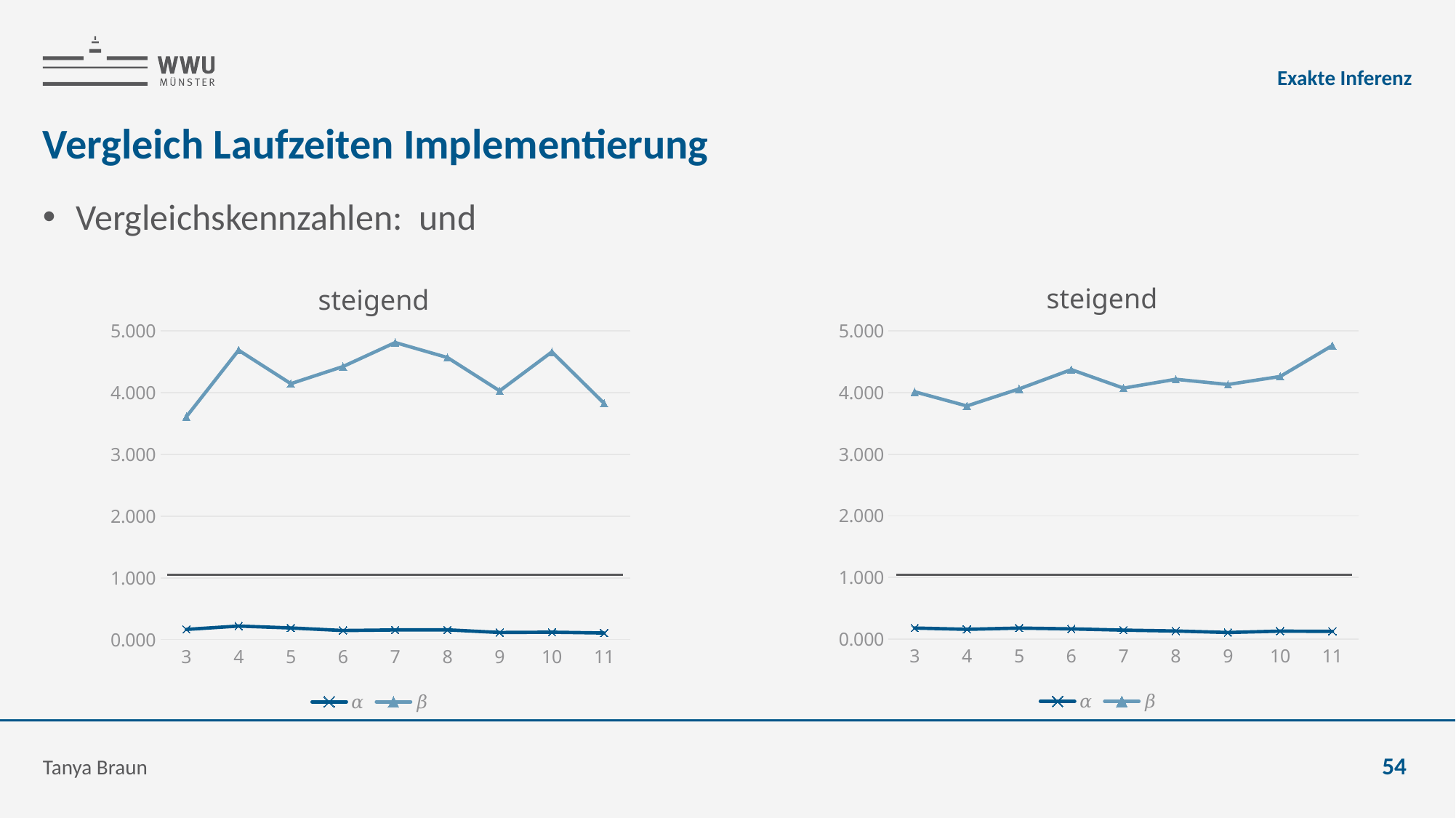
How many series does the legend of the right chart list? 2 In the right chart, at which x value is β lowest? 4 In the left chart, is the value of β at x = 7 greater or less than 4.000? greater What kind of chart is the left chart? line chart In the right chart, is the value of β at x = 4 greater or less than 4.000? less In the left chart, is the value of β at x = 3 greater or less than 4.000? less What is the title of the right chart? steigend How many x-axis points are plotted in the left chart? 9 In the left chart, which series has the larger value at x = 7, α or β? β In the right chart, at which x value is β highest? 11